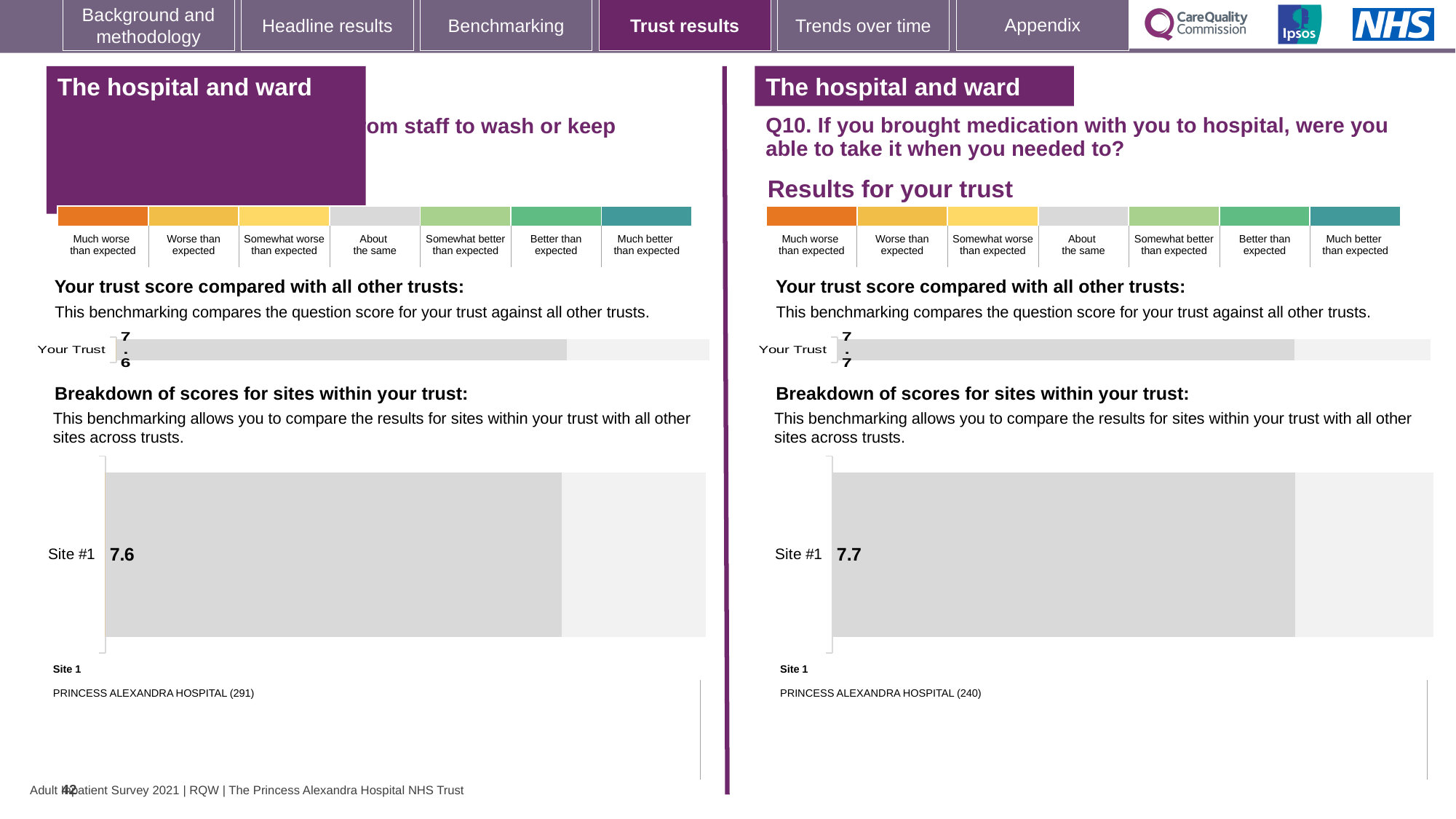
On the right-hand side (Q10), which hospital is listed as Site 1 below the breakdown chart? PRINCESS ALEXANDRA HOSPITAL (240) How many sites are shown in the 'Breakdown of scores for sites within your trust' chart on the left-hand side? 1 On the left-hand side of the slide, what is the score shown for Your Trust in the 'Your trust score compared with all other trusts' chart? 7.6 What is the difference between the Site #1 score on the right-hand (Q10) chart and the Site #1 score on the left-hand chart? 0.1 On the right-hand side of the slide (Q10), what score is shown for Site #1 in the 'Breakdown of scores for sites within your trust' chart? 7.7 On the left-hand side of the slide, what score is shown for Site #1 in the 'Breakdown of scores for sites within your trust' chart? 7.6 Which is larger: the Site #1 score on the left-hand chart or the Site #1 score on the right-hand (Q10) chart? Right-hand (Q10) chart On the left-hand side, which hospital is listed as Site 1 below the breakdown chart? PRINCESS ALEXANDRA HOSPITAL (291) How many sites are shown in the 'Breakdown of scores for sites within your trust' chart on the right-hand side (Q10)? 1 What type of chart is used to show the Site #1 score on the right-hand side (Q10)? Bar chart On the right-hand side of the slide (Q10), what is the score shown for Your Trust in the 'Your trust score compared with all other trusts' chart? 7.7 Is the Your Trust score on the right-hand (Q10) chart greater or less than 7? greater